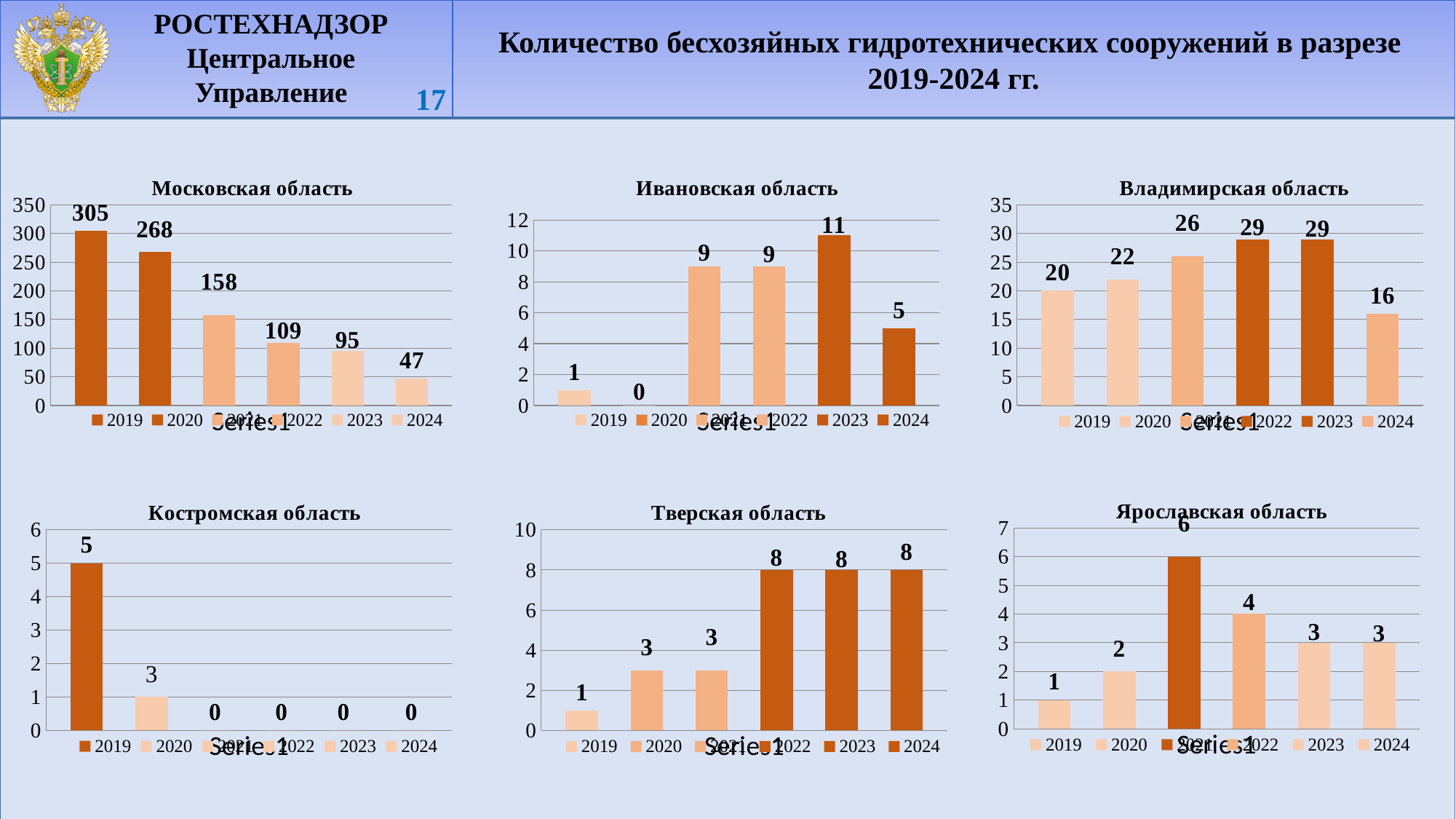
In the Тверская область chart, what is the value for 2022? 8 How many years (categories) are shown in the Ярославская область chart? 6 In the Ярославская область chart, what is the difference between the 2021 and 2022 values? 2 In the Ивановская область chart, what is the value for 2020? 0 In the Московская область chart, what is the value for 2019? 305 What type of chart is the Тверская область chart? bar chart In the Московская область chart, what is the difference between the 2019 and 2024 values? 258 In the Московская область chart, do the values rise or fall from 2019 to 2024? fall In the Владимирская область chart, which year has the lowest value? 2024 In the Костромская область chart, which is larger, the value for 2019 or the value for 2020? 2019 In the Владимирская область chart, what is the value for 2021? 26 In the Ивановская область chart, which year has the highest value? 2023